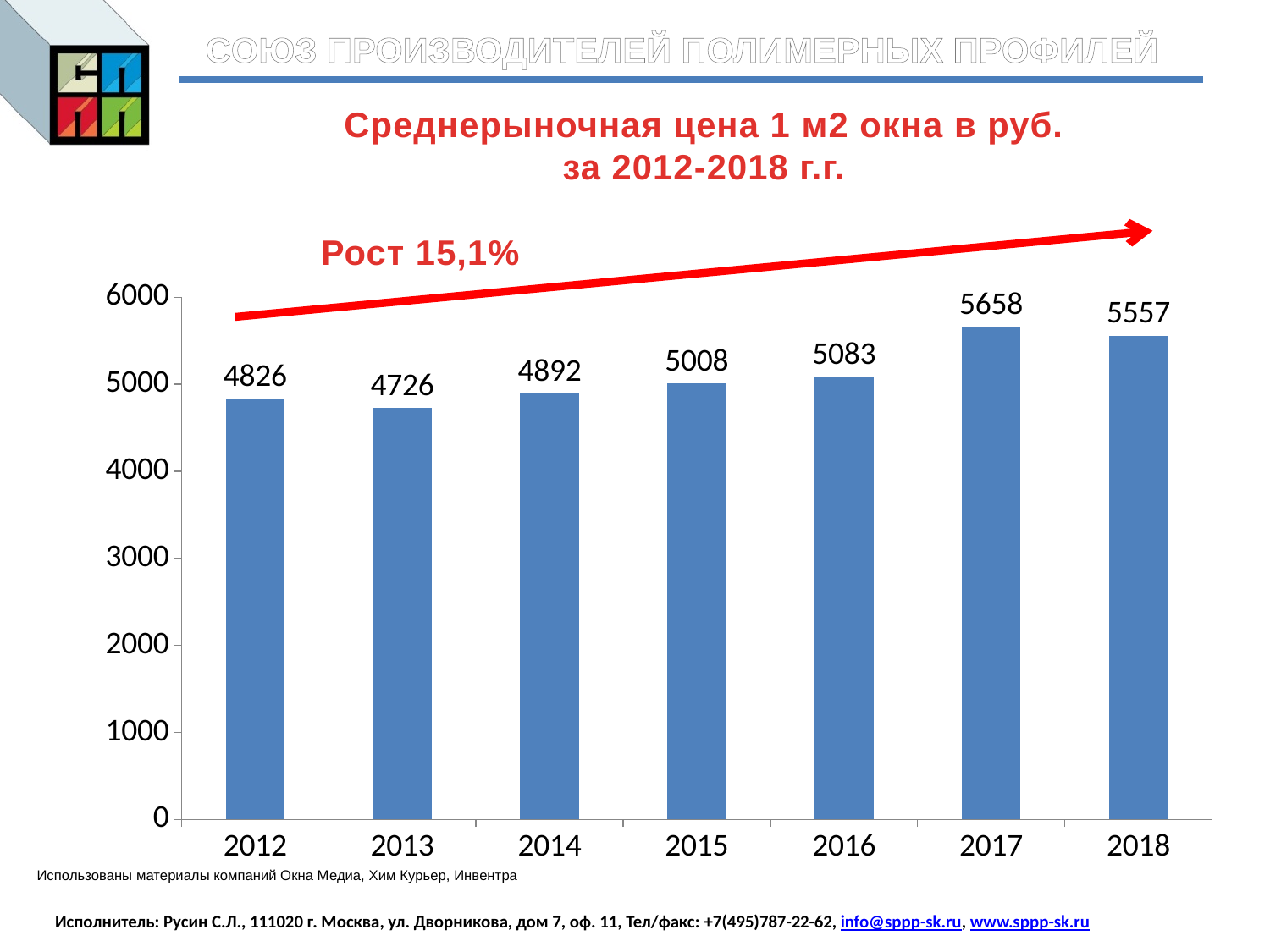
Which is larger, the value for 2014 or the value for 2016? 2016 What is the value for 2018? 5557 Which year has the highest value? 2017 How many years are shown on the x axis? 7 Is the value for 2017 greater or less than 5000? greater What is the value for 2012? 4826 Which year has the lowest value? 2013 What is the difference between the values for 2012 and 2013? 100 What is the value for 2015? 5008 What kind of chart is shown on the slide? bar chart What growth percentage is written above the chart next to the red arrow? Рост 15,1% What is the difference between the values for 2017 and 2018? 101